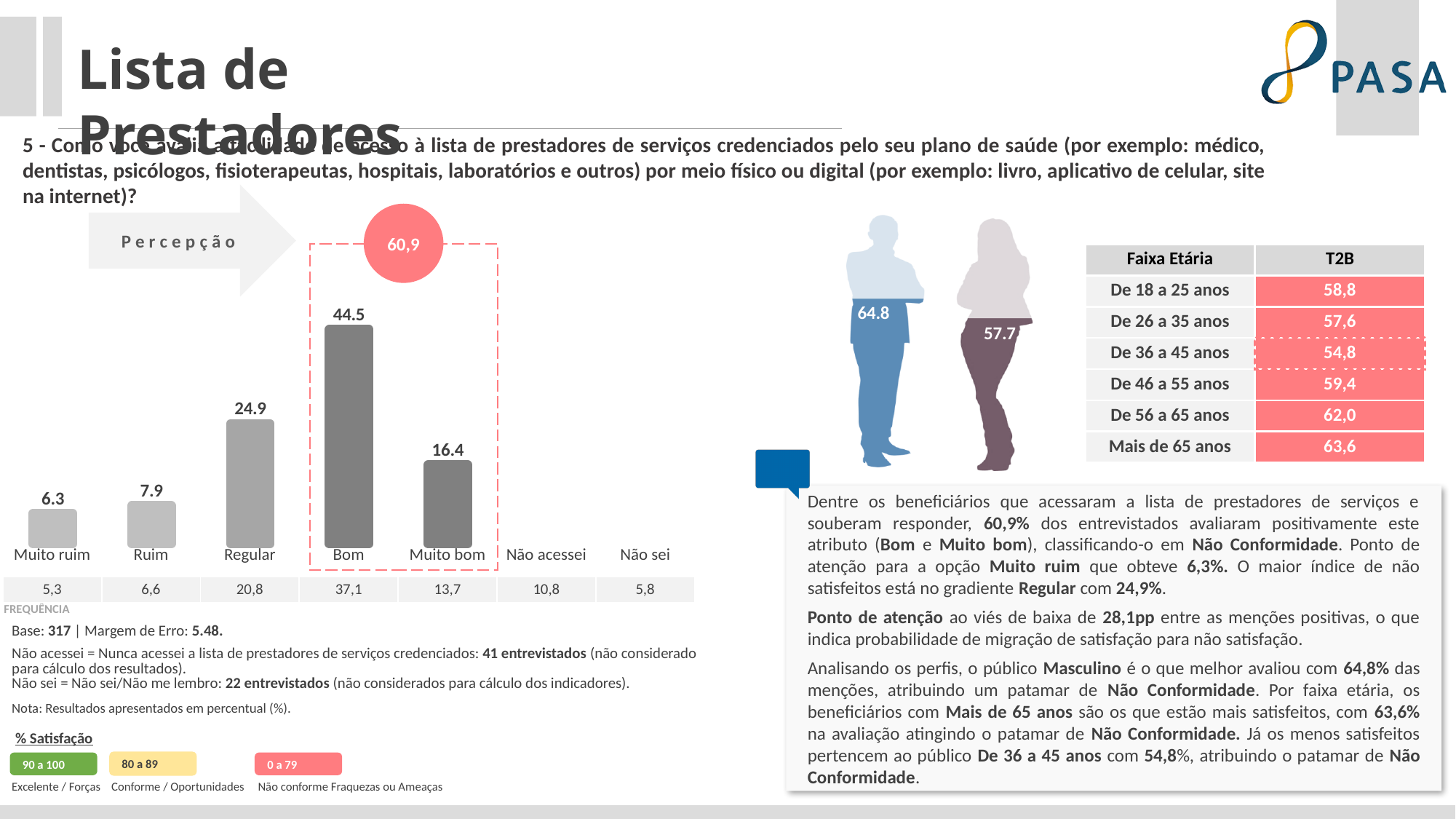
How many bars are plotted in the bar chart? 5 What is the difference between the values for Bom and Muito bom in the bar chart? 28.1 What is the value for Muito ruim in the bar chart? 6.3 What is the value for Regular in the bar chart? 24.9 What is the value for Muito bom in the bar chart? 16.4 Which is larger in the bar chart, Regular or Muito bom? Regular What is the difference between the values for Ruim and Muito ruim in the bar chart? 1.6 What is the value for Bom in the bar chart? 44.5 What is the combined value of Bom and Muito bom shown in the circle above the bar chart? 60,9 What kind of chart is used to show the Percepção results? Bar chart Which category has the highest value in the bar chart? Bom Which category has the lowest plotted value in the bar chart? Muito ruim